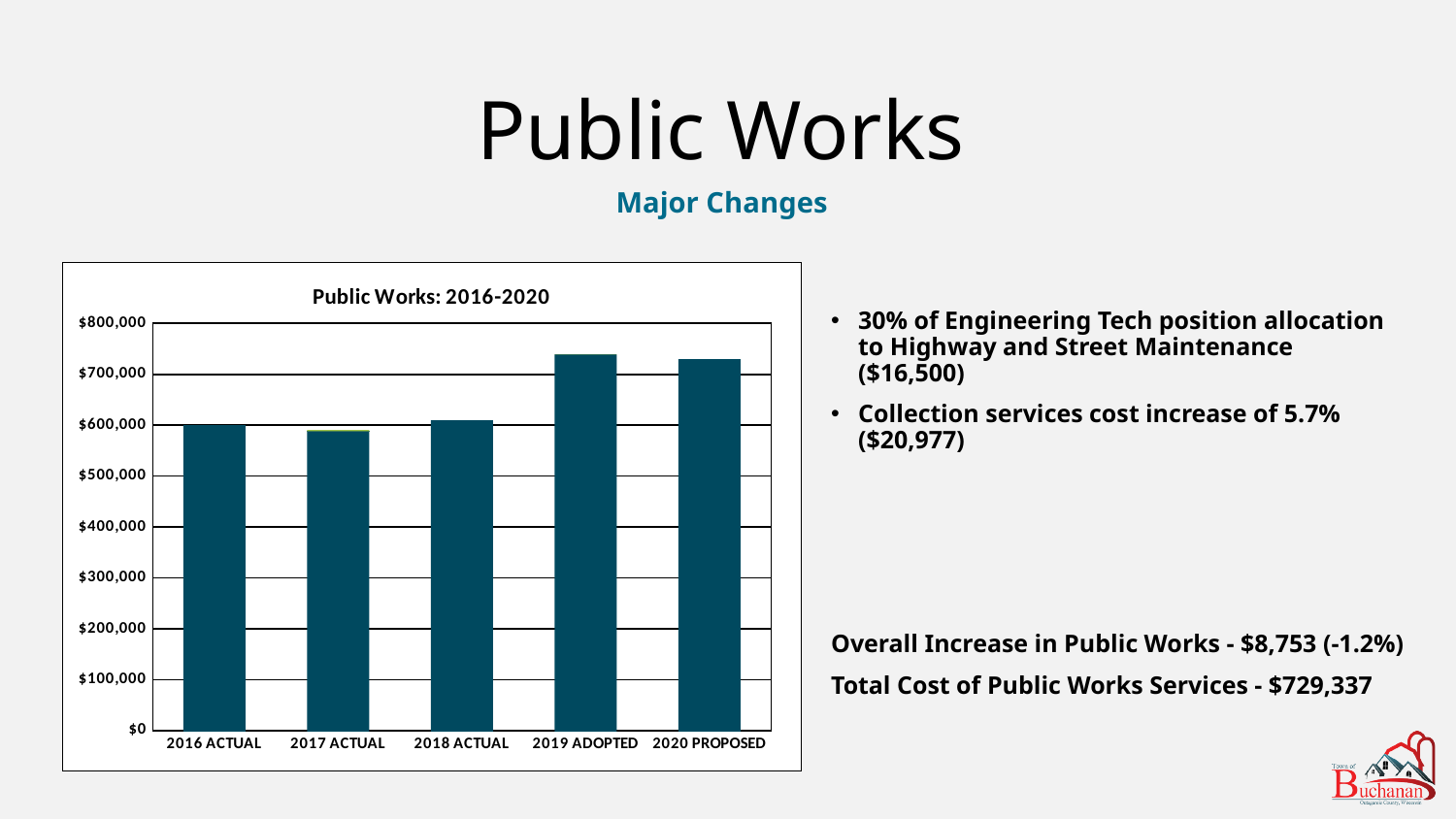
Which is larger, the value for 2019 ADOPTED or the value for 2016 ACTUAL? 2019 ADOPTED Which category is the last one on the x axis of the chart? 2020 PROPOSED Is the value for 2017 ACTUAL greater or less than $700,000? less Which is larger, the value for 2017 ACTUAL or the value for 2020 PROPOSED? 2020 PROPOSED What is the title of the chart on the slide? Public Works: 2016-2020 How many bars (categories) are plotted in the chart? 5 What type of chart is shown on the slide? Bar chart Is the value for 2020 PROPOSED greater or less than $700,000? greater Is the value for 2019 ADOPTED greater or less than $700,000? greater What is the highest value shown on the chart's vertical axis? $800,000